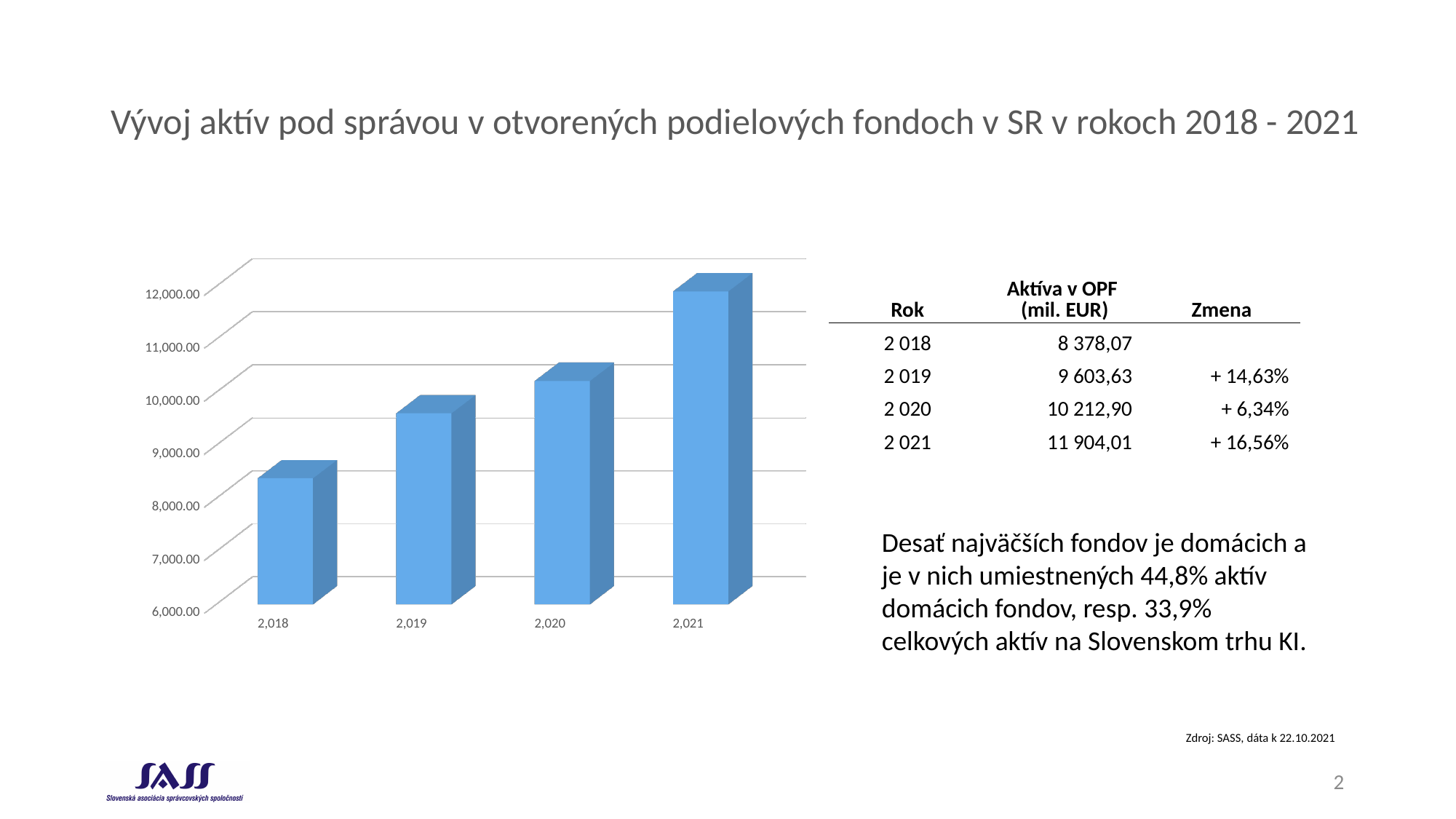
Is the value for 2021 greater or less than 11,000.00? greater According to the table next to the chart, what was the change (Zmena) in 2019? + 14,63% Which bar is taller, 2019 or 2020? 2020 According to the table next to the chart, what were the assets in OPF (mil. EUR) in 2021? 11 904,01 Is the value for 2020 greater or less than 11,000.00? less Which year has the highest bar in the chart? 2021 Is the value for 2018 greater or less than 8,000.00? greater What is the title of the slide above the chart? Vývoj aktív pod správou v otvorených podielových fondoch v SR v rokoch 2018 - 2021 Which year has the lowest bar in the chart? 2018 What kind of chart is shown on the slide? bar chart Do the values in the chart rise or fall from 2018 to 2021? rise How many bars (years) does the chart show? 4